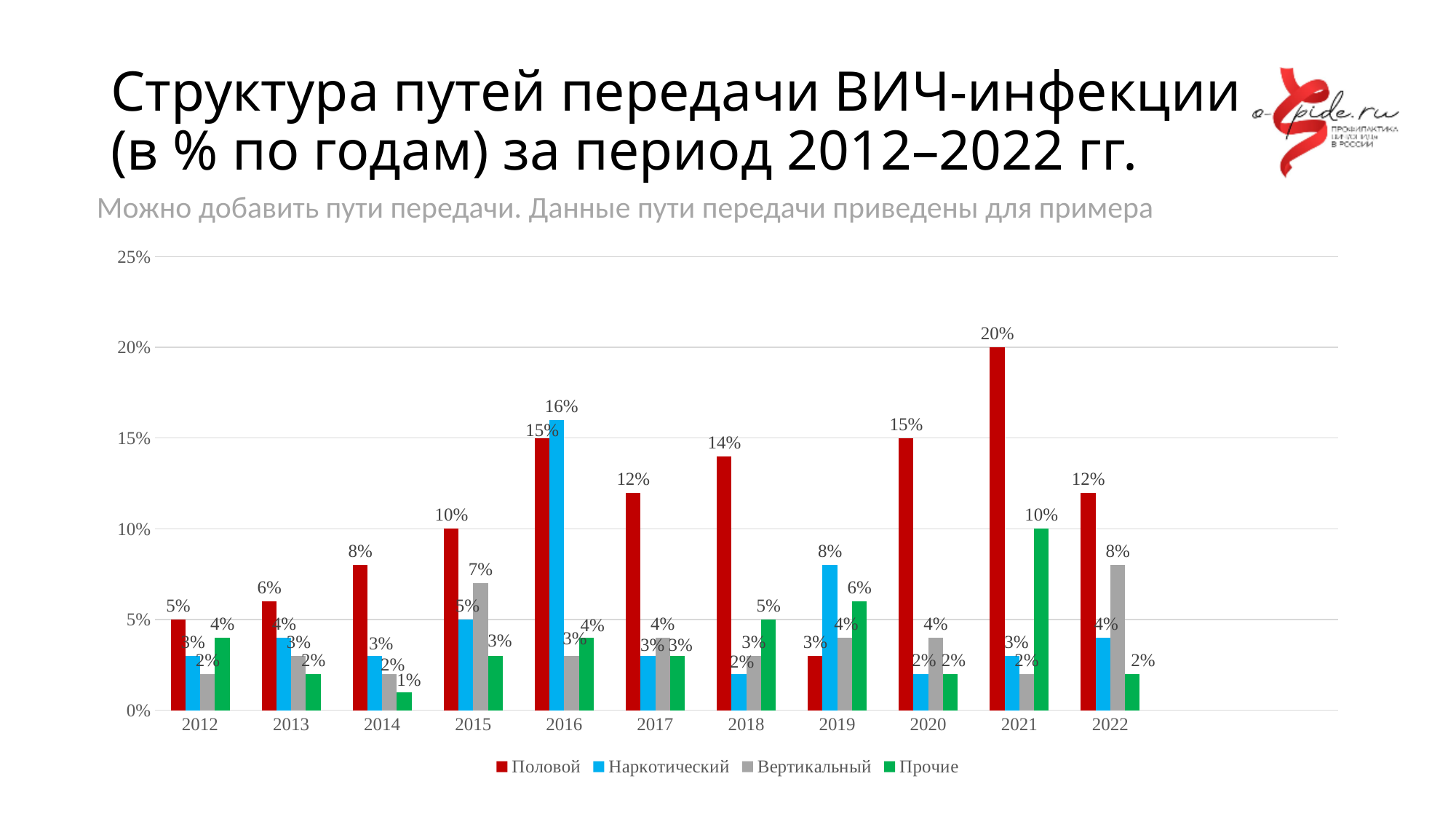
Which series is shown in green in the legend? Прочие What is the value for Наркотический in 2016? 16% In which year is the Половой series lowest? 2019 How many years are shown on the x axis? 11 What is the value for Половой in 2021? 20% How many series does the legend list? 4 In which year is the Половой series highest? 2021 What kind of chart is shown on the slide? Bar chart Which is larger in 2016, Половой or Наркотический? Наркотический What is the value for Вертикальный in 2022? 8% What is the difference between the Половой values in 2021 and 2022? 8% What is the value for Прочие in 2021? 10%